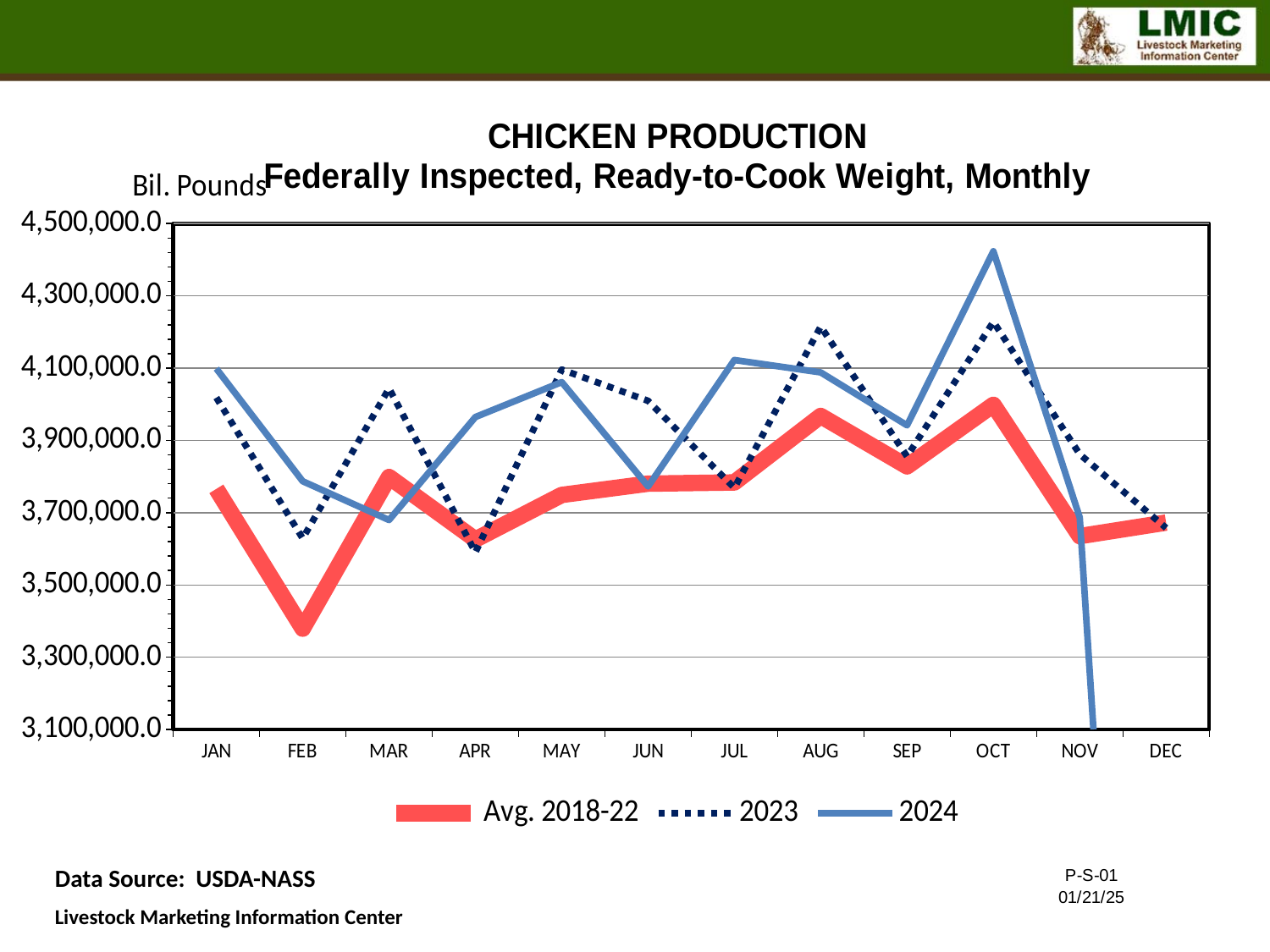
What kind of chart is shown on the slide? Line chart In which month is the Avg. 2018-22 series at its lowest? FEB How many series does the legend list? 3 Is the Avg. 2018-22 value for FEB greater or less than 3,500,000.0? less Is the 2023 value for FEB greater or less than 3,700,000.0? less Is the 2023 value for AUG greater or less than 4,100,000.0? greater What unit label is shown above the y axis? Bil. Pounds In which month does the 2024 series reach its highest value? OCT In JAN, which series has the higher value: 2024 or Avg. 2018-22? 2024 How many months are shown along the x axis? 12 Does the 2024 series rise or fall from MAR to MAY? Rise